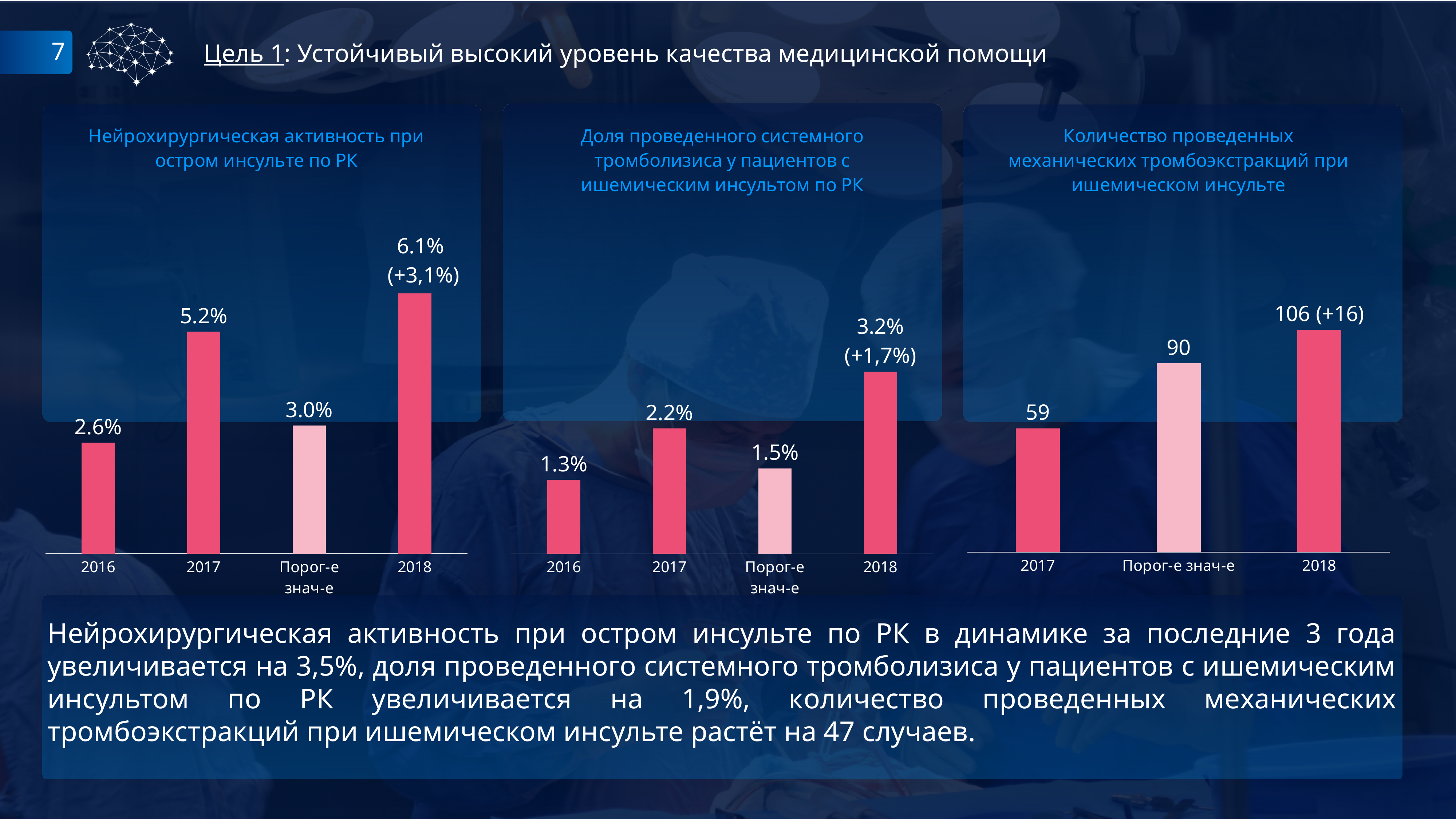
In the middle chart (Доля проведенного системного тромболизиса), which is larger: the value for 2017 or the value for Порог-е знач-е? 2017 In the middle chart (Доля проведенного системного тромболизиса), what is the value for Порог-е знач-е? 1.5% In the left chart (Нейрохирургическая активность при остром инсульте по РК), which category has the highest value? 2018 In the middle chart (Доля проведенного системного тромболизиса), how many bars are plotted? 4 In the right chart (Количество проведенных механических тромбоэкстракций), what is the value for 2017? 59 In the right chart (Количество проведенных механических тромбоэкстракций), how many categories are shown on the x axis? 3 In the middle chart (Доля проведенного системного тромболизиса), which category has the lowest value? 2016 In the left chart (Нейрохирургическая активность при остром инсульте по РК), what is the difference between the 2018 value and the 2016 value? 3.5% In the left chart (Нейрохирургическая активность при остром инсульте по РК), what is the value for 2017? 5.2% In the right chart (Количество проведенных механических тромбоэкстракций), what is the difference between the 2018 value and the 2017 value? 47 What type of chart is the right chart (Количество проведенных механических тромбоэкстракций)? Bar chart In the left chart (Нейрохирургическая активность при остром инсульте по РК), which bar is shown in a lighter pink colour than the others? Порог-е знач-е